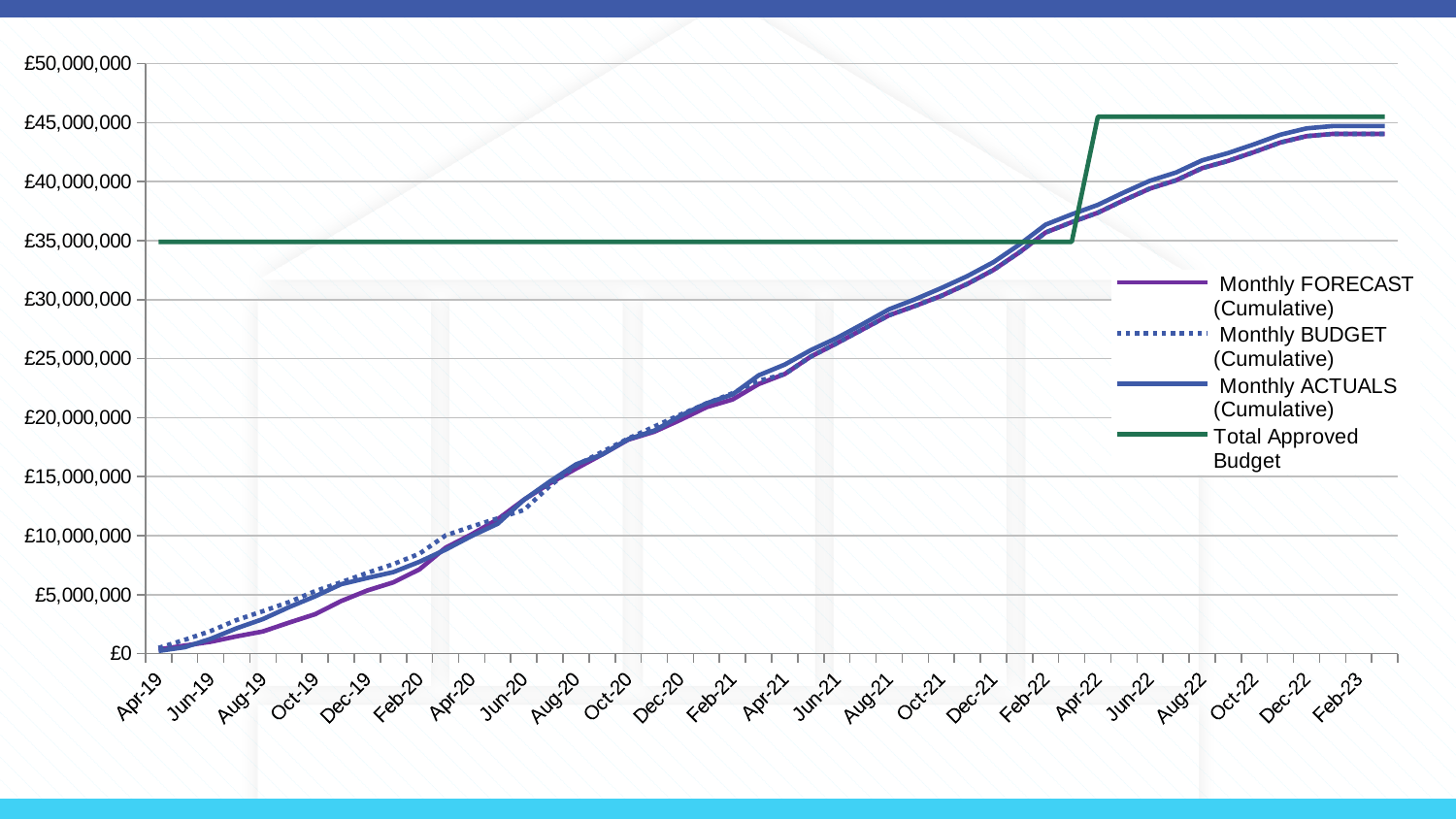
Does the Monthly ACTUALS (Cumulative) line rise or fall from Apr-19 to Feb-23? rise Is the value of the Total Approved Budget line in Feb-23 greater or less than £45,000,000? greater Is the value of Monthly FORECAST (Cumulative) in Feb-20 greater or less than £10,000,000? less What type of chart is shown on the slide? line chart In Feb-23, which is higher: the Total Approved Budget line or the Monthly ACTUALS (Cumulative) line? Total Approved Budget In Dec-19, which is higher: Monthly BUDGET (Cumulative) or Monthly FORECAST (Cumulative)? Monthly BUDGET (Cumulative) Is the value of Monthly ACTUALS (Cumulative) in Feb-23 greater or less than £45,000,000? less Which series is drawn with a dotted line? Monthly BUDGET (Cumulative) What colour is the Total Approved Budget line? green How many series does the legend list? 4